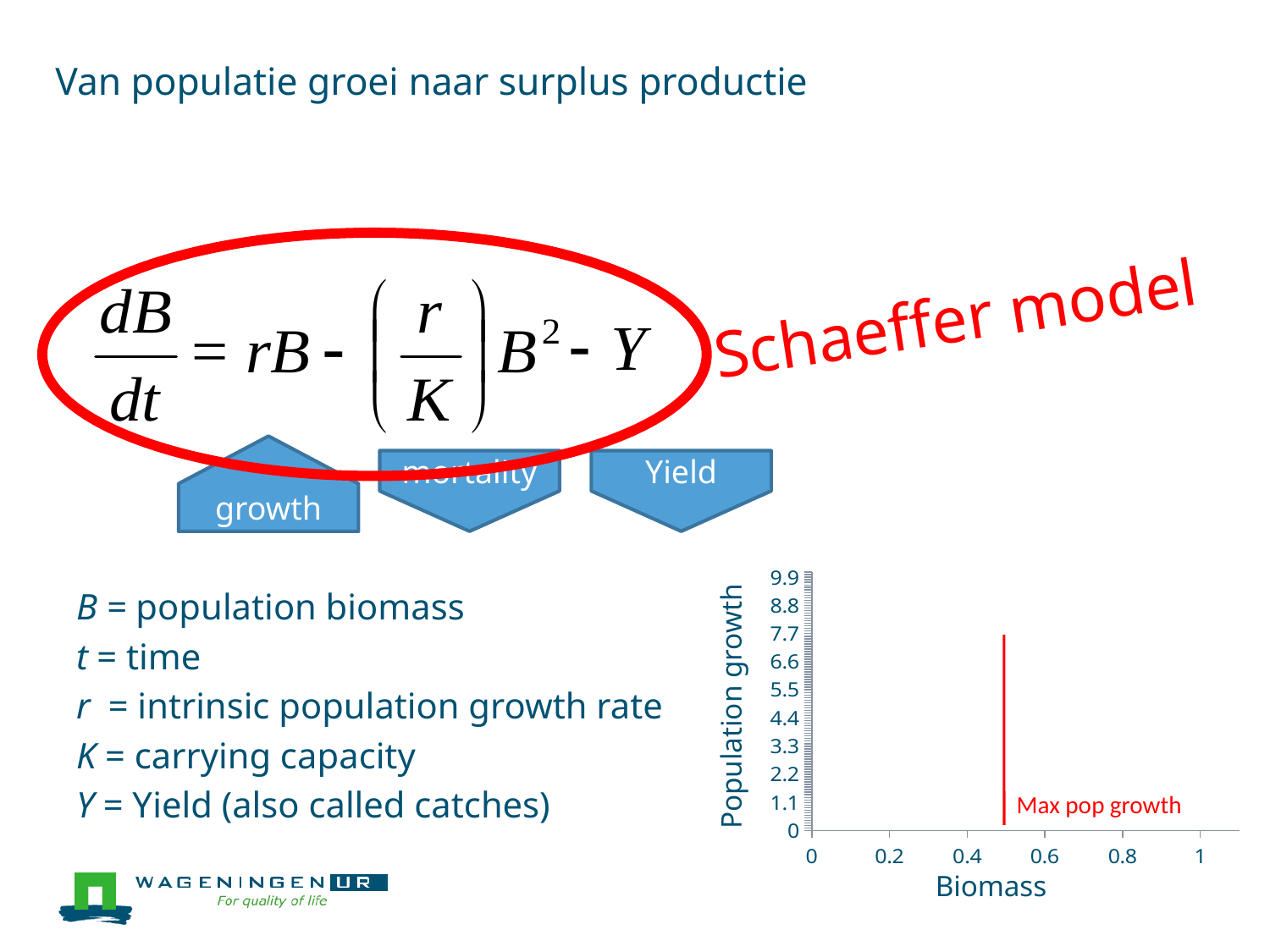
What is the label on the y axis of the chart? Population growth Is the red vertical line labelled "Max pop growth" positioned at a biomass greater or less than 0.4? greater Is the red vertical line labelled "Max pop growth" positioned at a biomass greater or less than 0.6? less What is the label on the x axis of the chart? Biomass